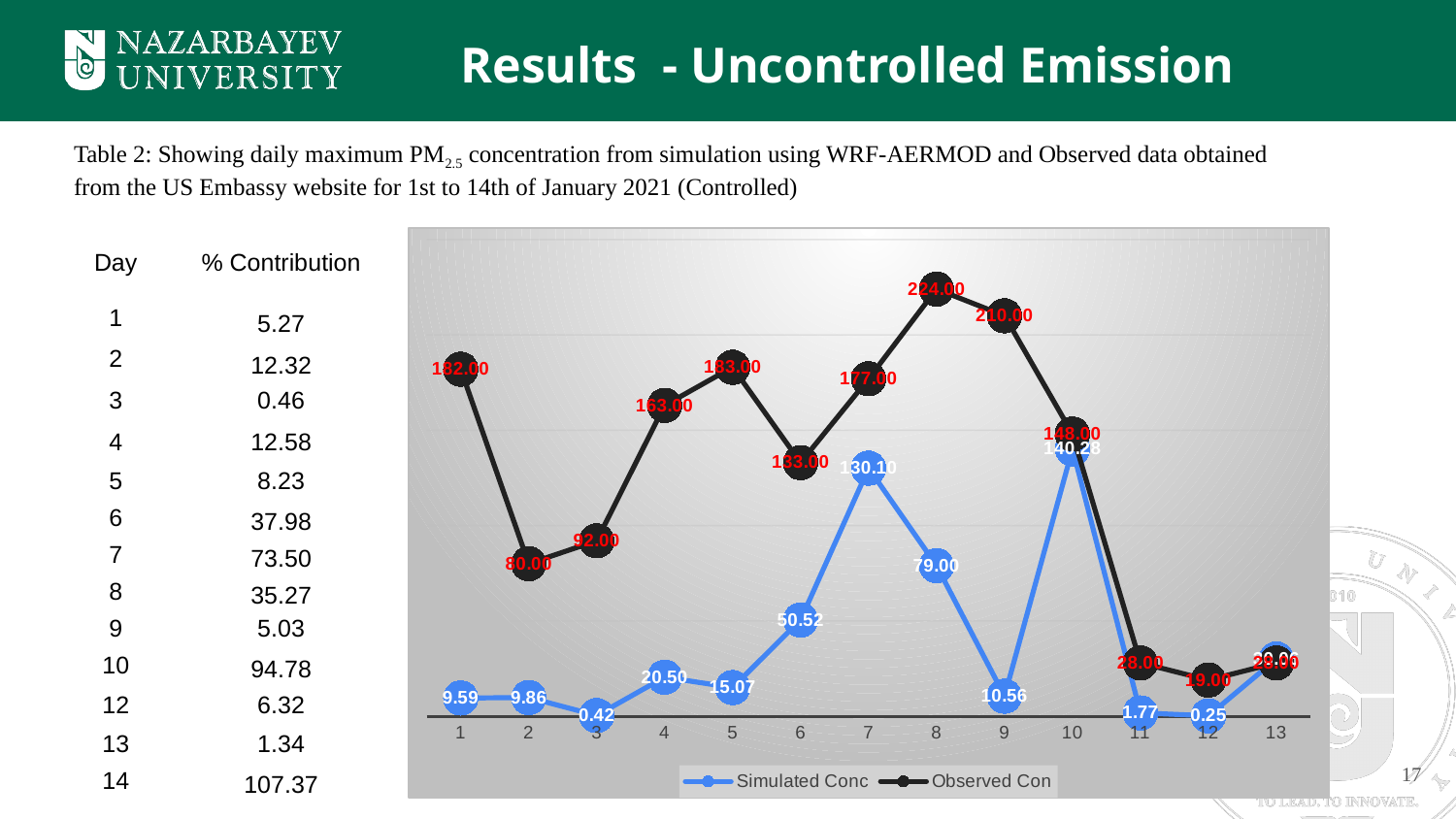
What is the Simulated Conc value on day 7? 130.10 How many series does the chart's legend list? 2 What is the Observed Con value on day 8? 224.00 What are the two entries in the chart's legend? Simulated Conc and Observed Con What is the Simulated Conc value on day 6? 50.52 On which day is the Observed Con value highest? 8 On which day is the Simulated Conc value lowest? 12 What kind of chart is shown on the slide? line chart What is the difference between the Observed Con values on day 8 and day 9? 14.00 On day 2, which series has the larger value, Simulated Conc or Observed Con? Observed Con How many days are plotted along the x axis of the chart? 13 On which day is the Simulated Conc value highest? 10